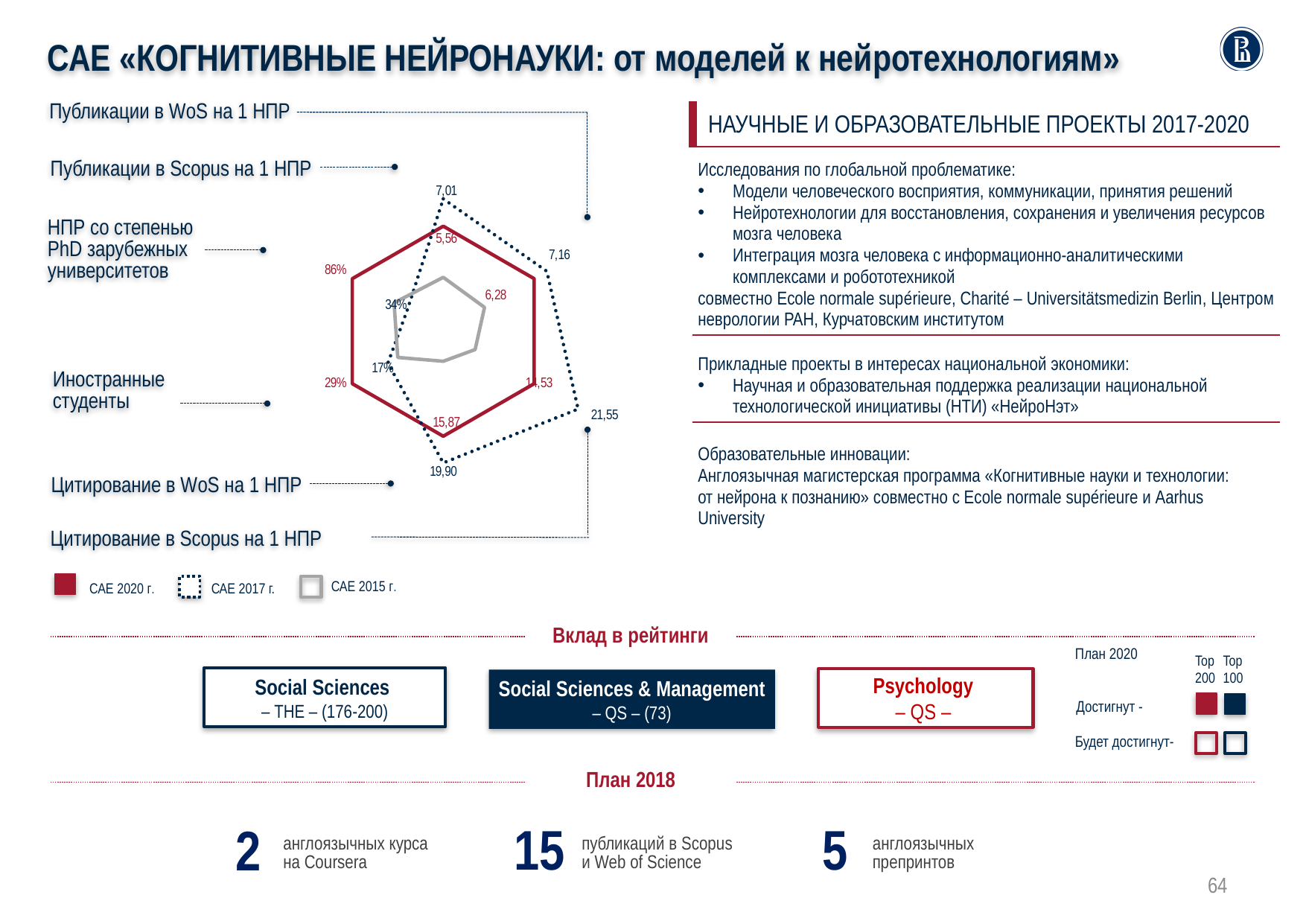
What is the САЕ 2020 г. value for «НПР со степенью PhD зарубежных университетов» on the radar chart? 86% How many series does the legend of the radar chart list? 3 What kind of chart is shown on the left of the slide? radar chart How many axes (categories) does the radar chart have? 6 What is the САЕ 2020 г. value for «Цитирование в WoS на 1 НПР» on the radar chart? 15,87 For «Публикации в Scopus на 1 НПР», which series has the larger value on the radar chart: САЕ 2017 г. or САЕ 2020 г.? САЕ 2017 г. What is the САЕ 2017 г. value for «Цитирование в Scopus на 1 НПР» on the radar chart? 21,55 What are the three series named in the legend of the radar chart? САЕ 2020 г., САЕ 2017 г., САЕ 2015 г. By how many percentage points does the САЕ 2020 г. value for «НПР со степенью PhD зарубежных университетов» exceed the САЕ 2015 г. value? 52 What is the САЕ 2015 г. value for «НПР со степенью PhD зарубежных университетов» on the radar chart? 34% What is the САЕ 2015 г. value for «Иностранные студенты» on the radar chart? 17% What is the САЕ 2020 г. value for «Иностранные студенты» on the radar chart? 29%